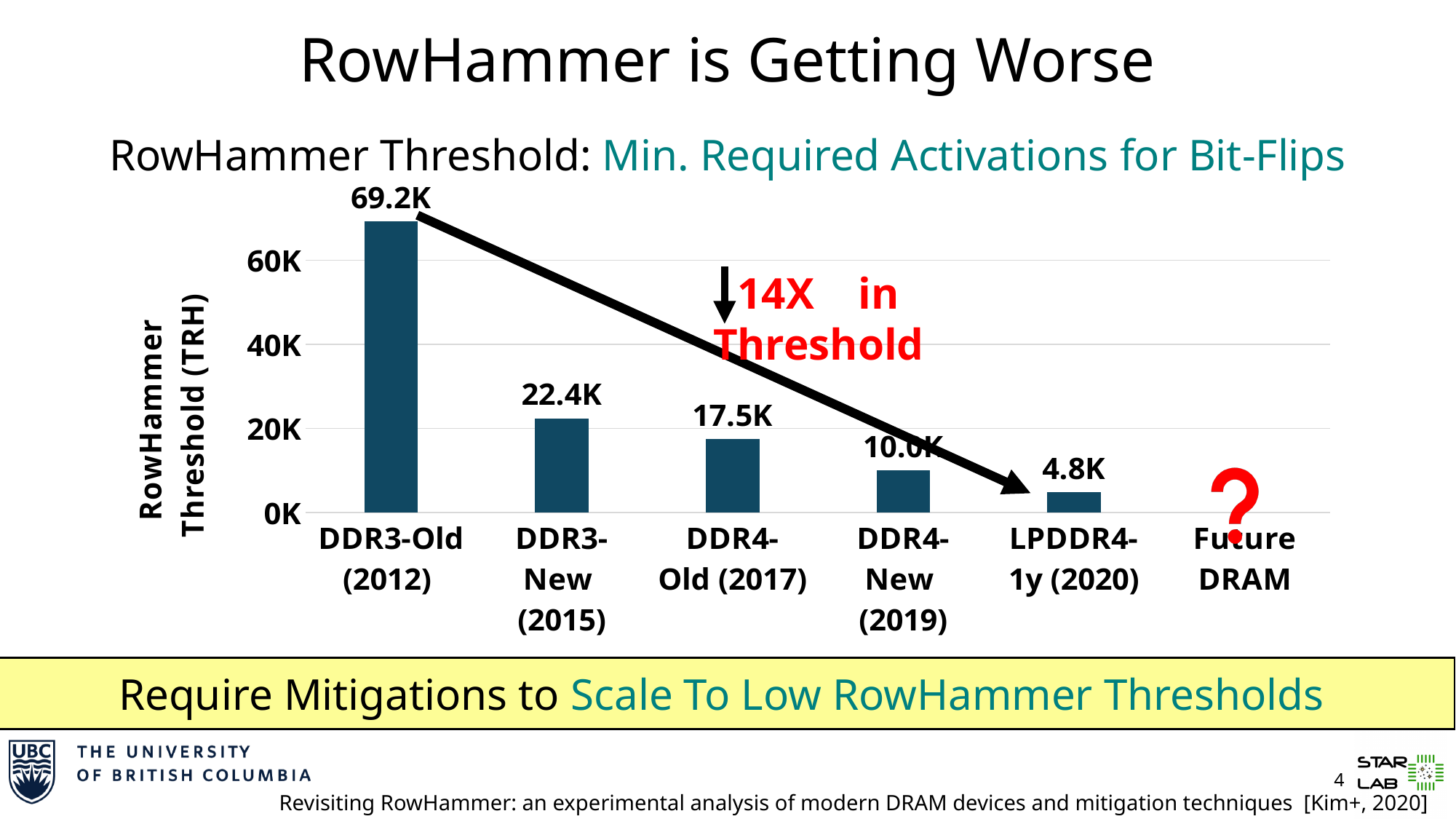
How many bars are plotted in the chart? 5 What is the difference between the RowHammer thresholds of DDR3-Old (2012) and DDR3-New (2015)? 46.8K What is the RowHammer threshold for DDR3-Old (2012)? 69.2K What type of chart is shown on the slide? bar chart What is the RowHammer threshold for DDR4-Old (2017)? 17.5K Is the value for DDR4-New (2019) greater or less than 20K? less Which DRAM generation has the highest RowHammer threshold? DDR3-Old (2012) What is the RowHammer threshold for DDR3-New (2015)? 22.4K Which DRAM generation with a plotted bar has the lowest RowHammer threshold? LPDDR4-1y (2020) Which has a larger RowHammer threshold, DDR3-New (2015) or DDR4-Old (2017)? DDR3-New (2015) Do the RowHammer threshold values rise or fall from left to right along the x axis? fall What is the RowHammer threshold for LPDDR4-1y (2020)? 4.8K